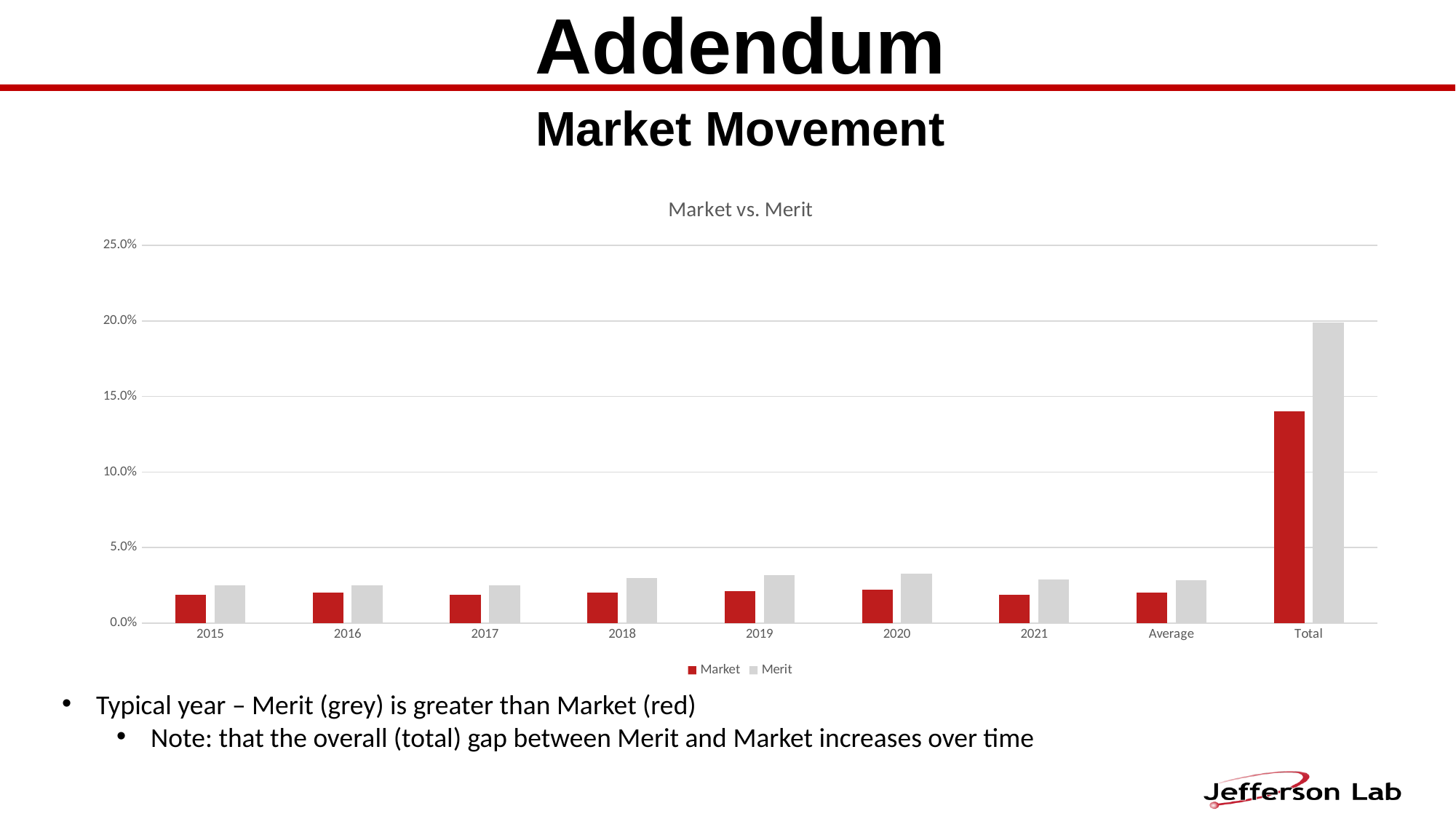
What is the title of the chart? Market vs. Merit How many series does the legend list? 2 Which category has the highest Market value? Total What kind of chart is shown on the slide? bar chart Which colour represents the Market series? red How many categories are shown on the x axis? 9 Is the Market value for 2015 greater or less than 5.0%? less Is the Market value for Total greater or less than 10.0%? greater Is the Merit value for Total greater or less than 25.0%? less Which category has the highest Merit value? Total For the Total category, which series has the larger value, Market or Merit? Merit